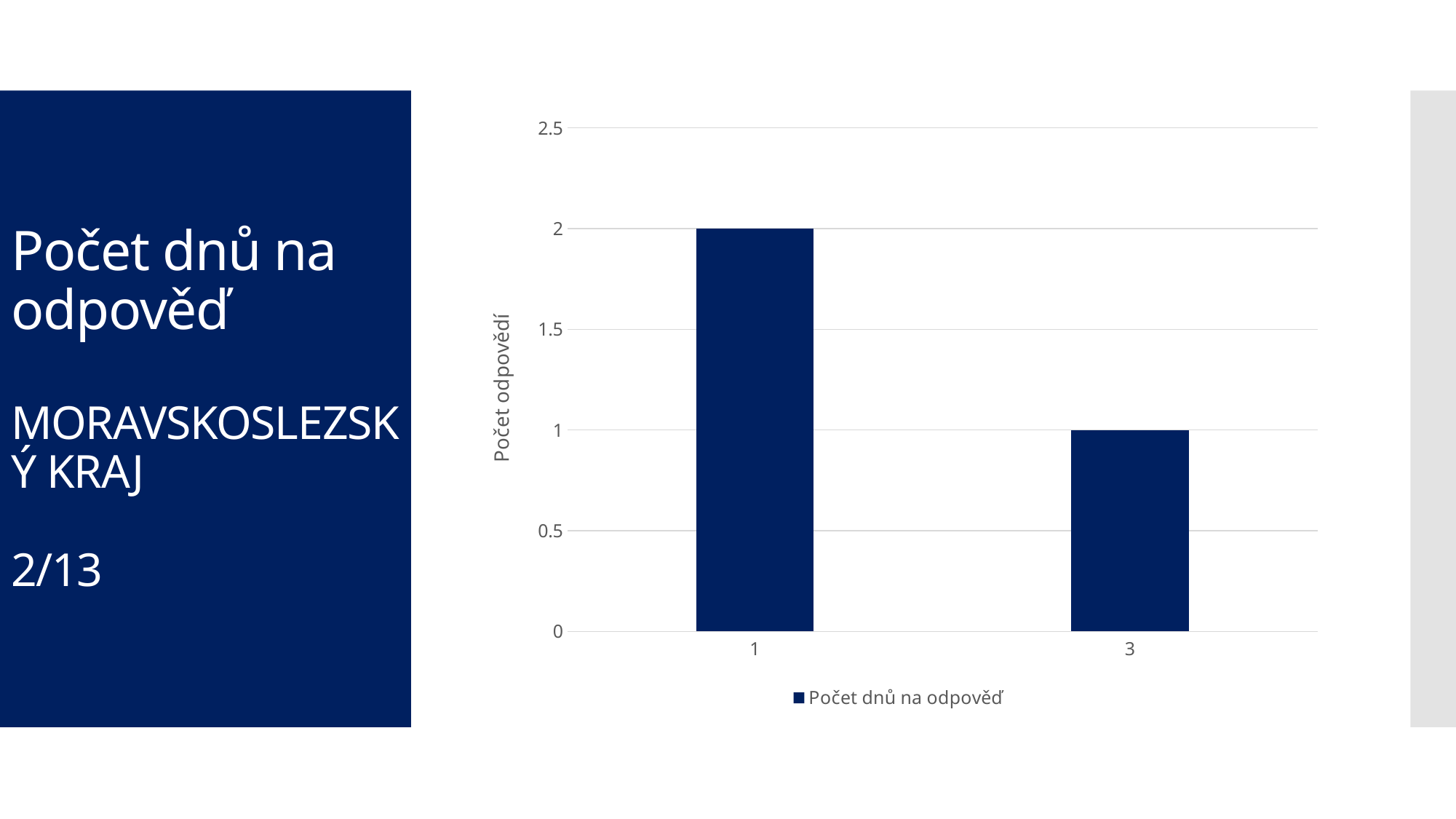
How many categories are shown on the x axis of the chart? 2 Which category has the highest value in the chart? 1 Do the values rise or fall from left to right along the x axis? fall Which category has the lowest value in the chart? 3 How many series does the chart legend list? 1 Is the value for category 1 greater or less than 1.5? greater What is the difference between the values for category 1 and category 3? 1 What type of chart is shown on the slide? bar chart Which category has the larger value, 1 or 3? 1 What is the value for category 3 in the chart? 1 What is the value for category 1 in the chart? 2 What is the label of the y axis in the chart? Počet odpovědí